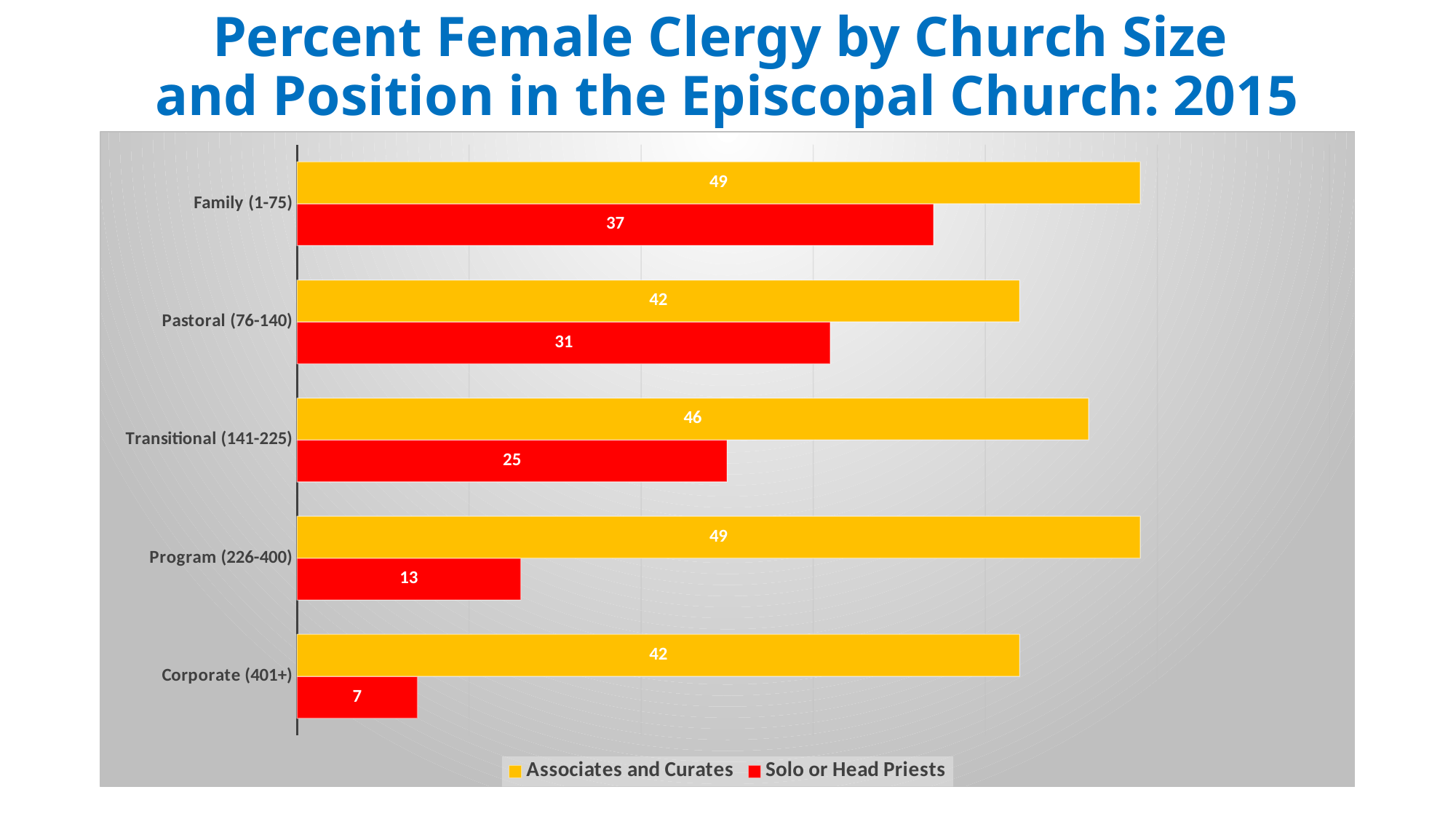
What is the difference between Associates and Curates and Solo or Head Priests in Program (226-400) churches? 36 Which church size has the highest value for Solo or Head Priests? Family (1-75) Which colour represents Solo or Head Priests in the chart? Red What kind of chart is shown on the slide? Bar chart What is the value for Solo or Head Priests in Corporate (401+) churches? 7 What is the difference between the Solo or Head Priests values for Family (1-75) and Transitional (141-225) churches? 12 How many series does the legend list? 2 What is the value for Solo or Head Priests in Pastoral (76-140) churches? 31 Which is larger in Pastoral (76-140) churches: Associates and Curates or Solo or Head Priests? Associates and Curates How many church size categories are shown on the chart? 5 Which church size has the lowest value for Solo or Head Priests? Corporate (401+) What is the value for Associates and Curates in Transitional (141-225) churches? 46